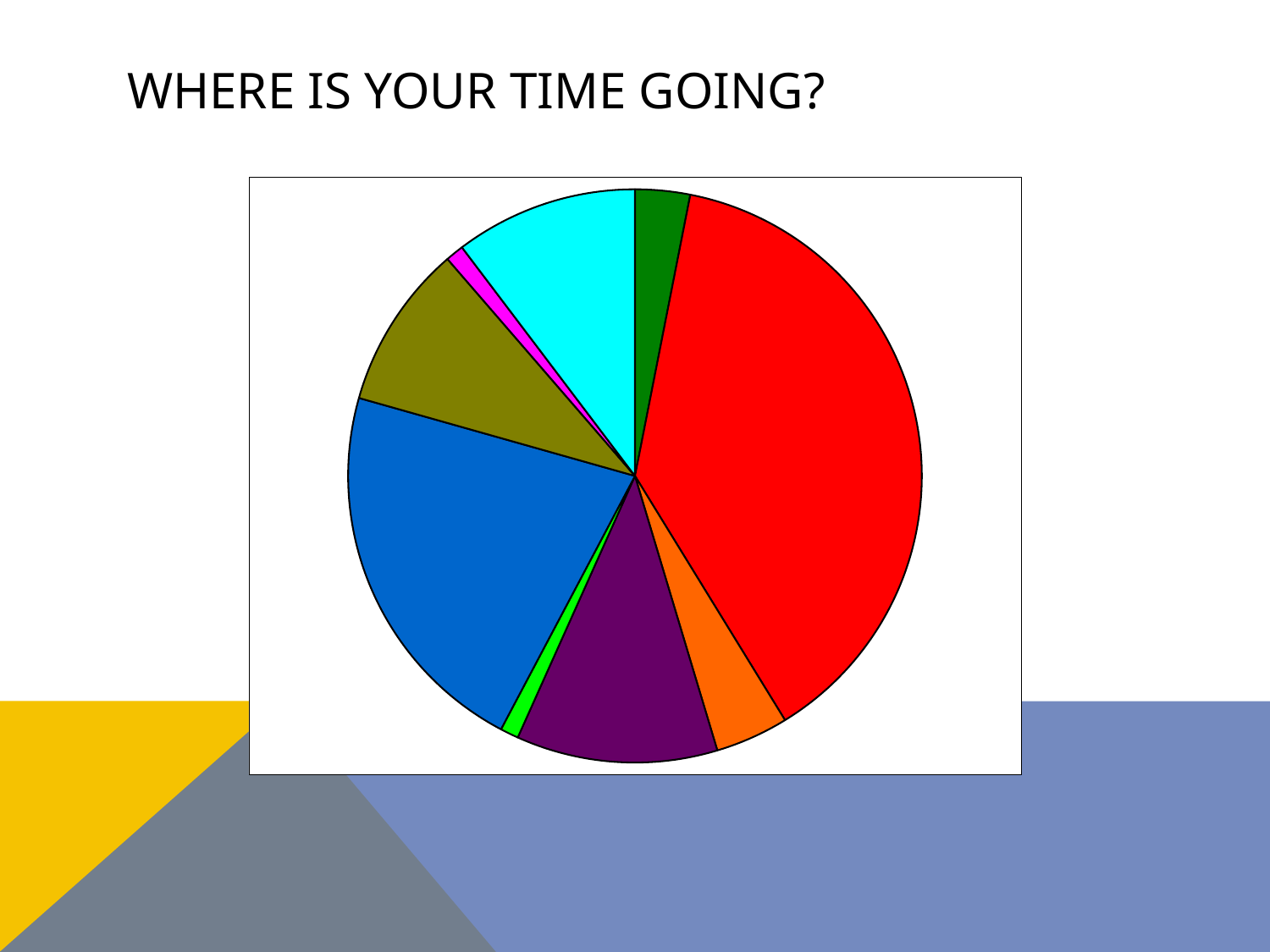
Which colour slice is the largest in the pie chart? red Which is larger in the pie chart, the blue slice or the purple slice? blue What is the title of the slide containing the pie chart? WHERE IS YOUR TIME GOING? Which is larger in the pie chart, the purple slice or the orange slice? purple Does the pie chart include a legend? No Does the red slice take up more or less than half of the pie chart? less Which is larger in the pie chart, the red slice or the blue slice? red How many slices does the pie chart have? 9 What kind of chart is shown on the slide? pie chart